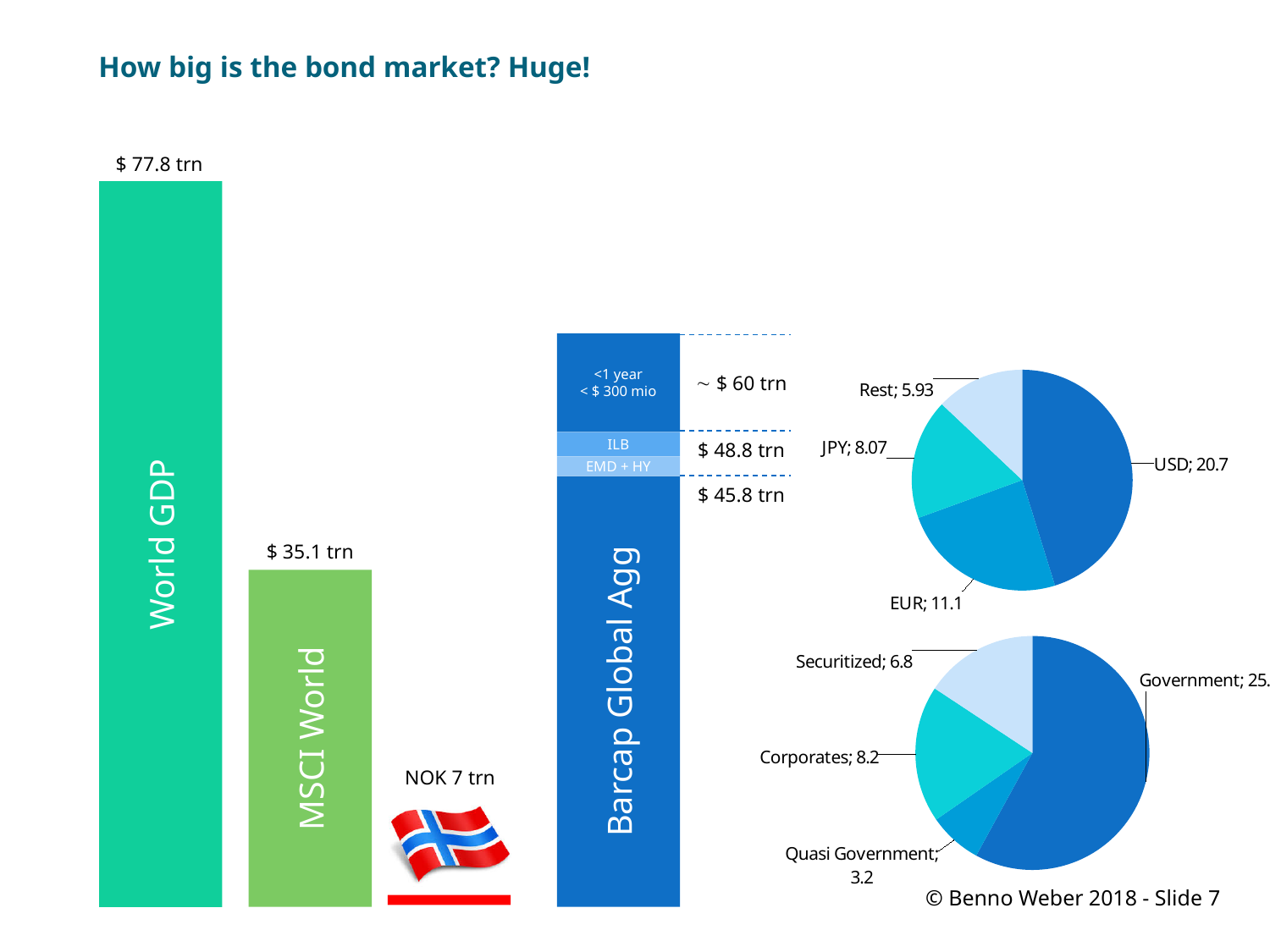
In the bar chart on the left, what is the value shown for MSCI World? $ 35.1 trn In the lower pie chart (sectors), which slice is the smallest? Quasi Government In the bar chart on the left, which is larger: MSCI World or the solid Barcap Global Agg bar? Barcap Global Agg In the bar chart on the left, what value is shown after adding the ILB and EMD + HY segments to the Barcap Global Agg bar? $ 48.8 trn In the lower pie chart (sectors), what is the value for Corporates? 8.2 In the bar chart on the left, what value is shown at the top of the solid Barcap Global Agg bar? $ 45.8 trn In the upper pie chart (currencies), which slice is the largest? USD In the upper pie chart (currencies), what is the value for EUR? 11.1 In the bar chart on the left, what is the difference between World GDP and MSCI World? $ 42.7 trn In the bar chart on the left, what is the value shown for World GDP? $ 77.8 trn In the bar chart on the left, which bar is the tallest? World GDP In the bar chart on the left, what value is printed next to the Norwegian flag? NOK 7 trn